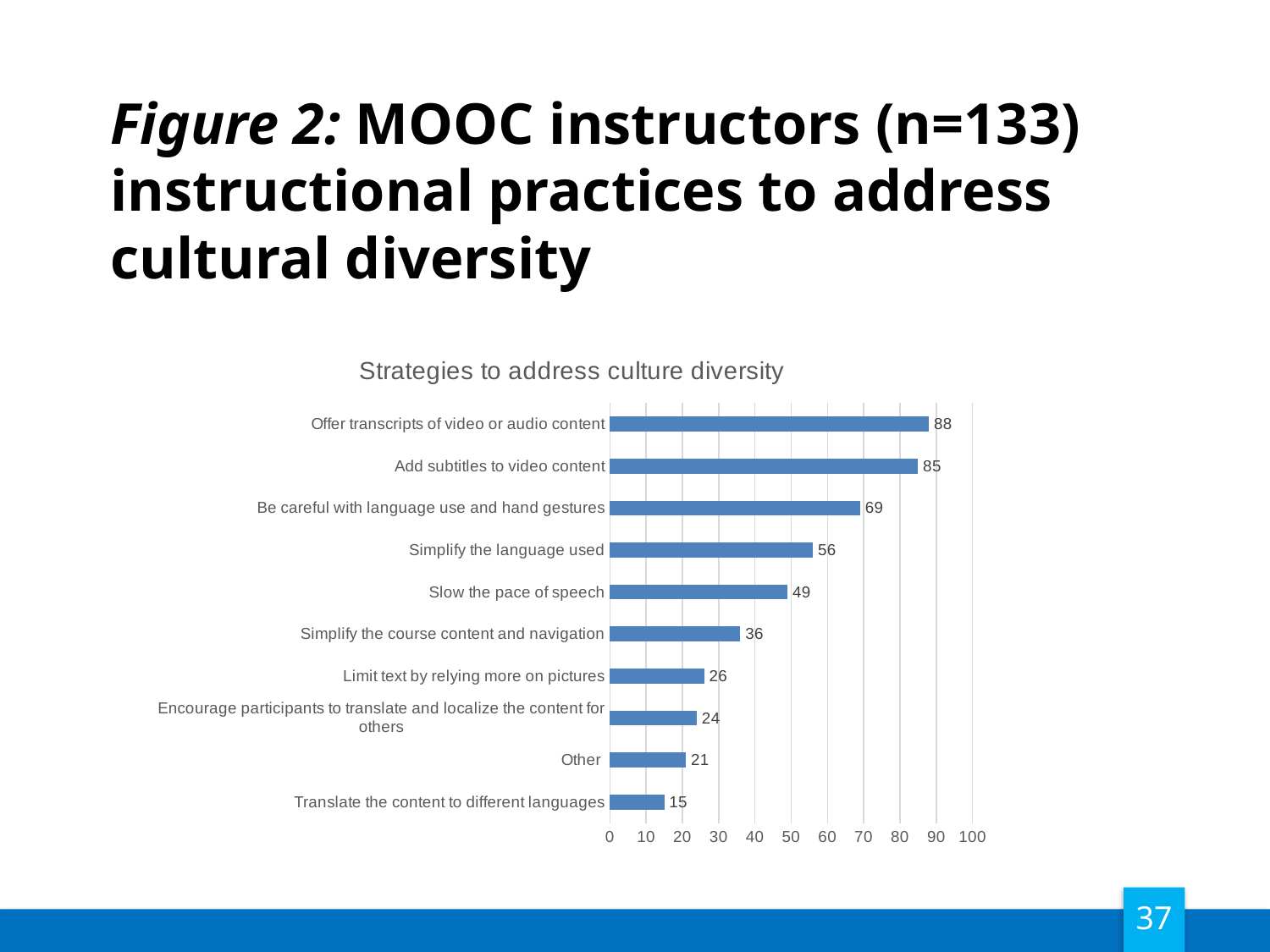
How many strategies are shown in the chart? 10 What is the difference between the values for "Add subtitles to video content" and "Simplify the language used"? 29 What is the value for "Slow the pace of speech"? 49 Is the value for "Be careful with language use and hand gestures" greater or less than 60? greater Which strategy has the highest value? Offer transcripts of video or audio content Which is larger: the value for "Limit text by relying more on pictures" or the value for "Encourage participants to translate and localize the content for others"? Limit text by relying more on pictures What is the title of the chart? Strategies to address culture diversity What is the maximum value shown on the horizontal axis? 100 What kind of chart is shown on the slide? bar chart What is the value for "Other"? 21 What is the value for "Offer transcripts of video or audio content"? 88 Which strategy has the lowest value? Translate the content to different languages